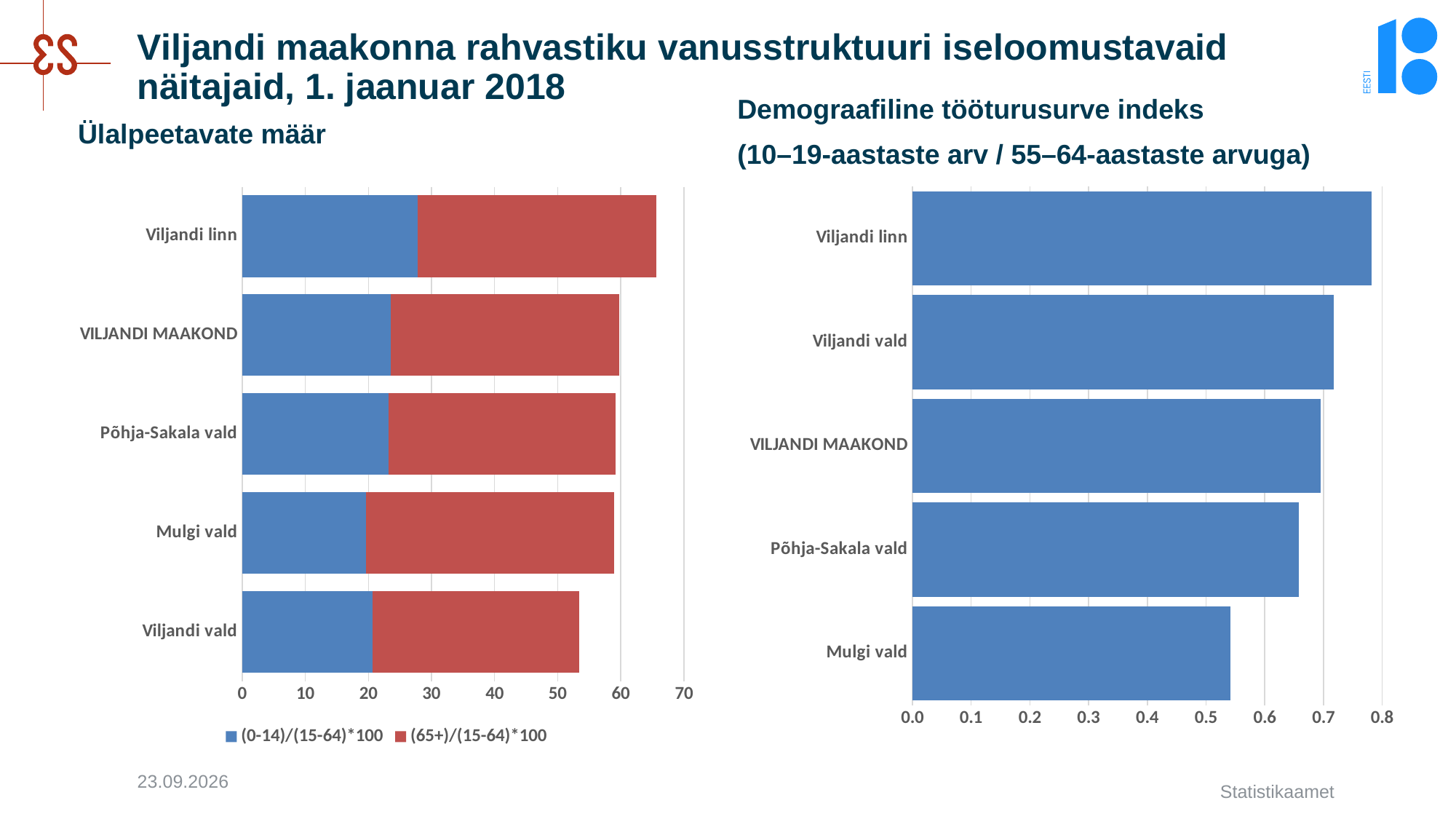
What type of chart is the 'Ülalpeetavate määr' chart on the left? Stacked bar chart In the 'Ülalpeetavate määr' chart, which is larger: the (0-14)/(15-64)*100 value for Viljandi linn or for Mulgi vald? Viljandi linn In the 'Ülalpeetavate määr' chart, is the total bar for Viljandi linn greater or less than 60? greater How many categories are shown in the 'Ülalpeetavate määr' chart? 5 In the 'Demograafiline tööturusurve indeks' chart, is the value for Mulgi vald greater or less than 0.6? less In the 'Demograafiline tööturusurve indeks' chart, is the value for Viljandi linn greater or less than 0.7? greater How many series does the legend of the 'Ülalpeetavate määr' chart list? 2 In the 'Ülalpeetavate määr' chart, which category has the lowest total bar? Viljandi vald In the 'Demograafiline tööturusurve indeks' chart, which category has the highest value? Viljandi linn In the 'Demograafiline tööturusurve indeks' chart, which category has the lowest value? Mulgi vald In the 'Ülalpeetavate määr' chart, which category has the highest total bar? Viljandi linn